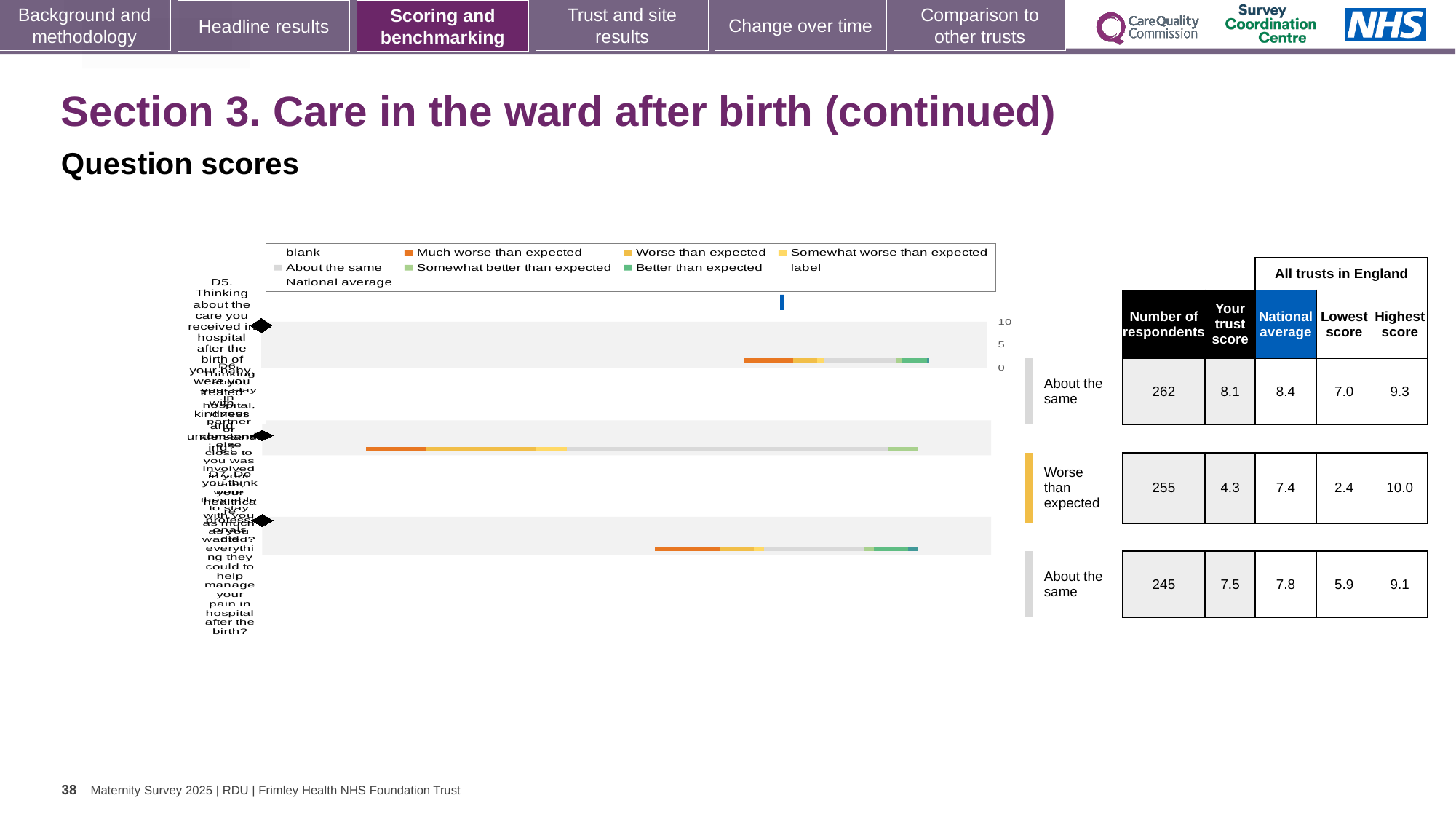
What benchmark category label is shown next to the second row of the chart? Worse than expected What kind of chart is shown on the slide? bar chart For the second row, what is the difference between the national average and the trust score? 3.1 What is the highest tick value shown on the chart's axis? 10 In the table beside the chart, what is the national average for the third row? 7.8 Which row has the lowest value in the 'Lowest score' column? second row In the table beside the chart, what is the trust score for the second row? 4.3 Which row has the highest value in the 'Highest score' column? second row For the second row, which is larger: the trust score or the national average? national average In the table beside the chart, what is the number of respondents for the first row? 262 How many question rows (bars) does the chart show? 3 How many entries does the chart's legend list? 9